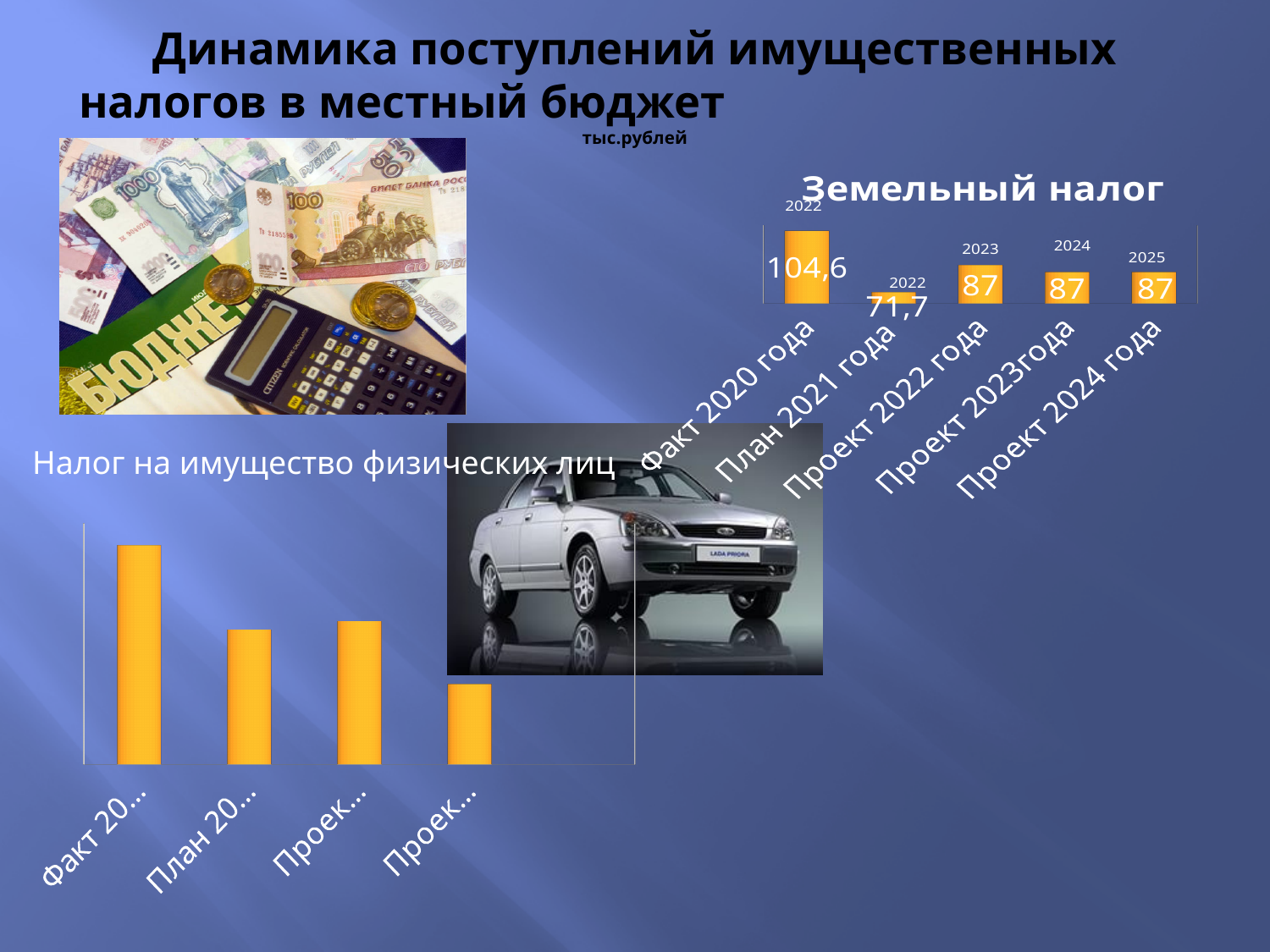
How many bars are shown in the 'Налог на имущество физических лиц' chart? 4 In the 'Налог на имущество физических лиц' chart, which bar is the tallest: the first or the last? The first In the 'Земельный налог' chart, what is the difference between the values for Факт 2020 года and План 2021 года? 32,9 In the 'Земельный налог' chart, which is larger: the value for План 2021 года or the value for Проект 2024 года? Проект 2024 года In the 'Земельный налог' chart, which category has the highest value? Факт 2020 года What kind of chart is the 'Налог на имущество физических лиц' chart? Bar chart In the 'Земельный налог' chart, which category has the lowest value? План 2021 года In the 'Земельный налог' chart, what is the value for Факт 2020 года? 104,6 In the 'Земельный налог' chart, what is the difference between the values for Проект 2023года and План 2021 года? 15,3 In the 'Земельный налог' chart, what is the value for План 2021 года? 71,7 How many categories are shown in the 'Земельный налог' chart? 5 In the 'Земельный налог' chart, what is the value for Проект 2022 года? 87